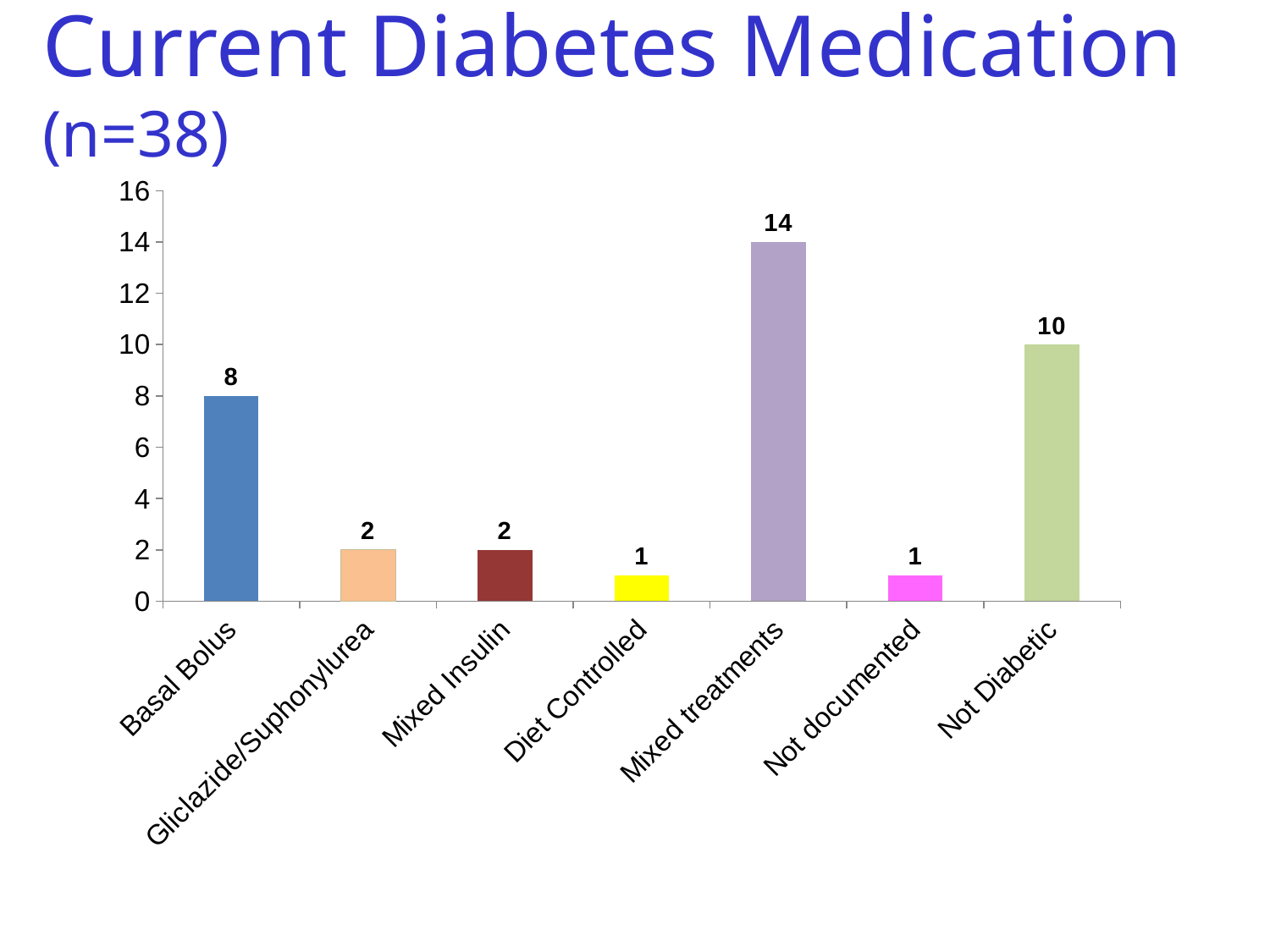
What is the value for Basal Bolus? 8 What is the value for Gliclazide/Suphonylurea? 2 Which is larger, the value for Basal Bolus or the value for Not Diabetic? Not Diabetic How many categories are shown on the x axis? 7 What is the difference between the values for Basal Bolus and Mixed Insulin? 6 What is the difference between the values for Mixed treatments and Not Diabetic? 4 Is the value for Mixed treatments greater or less than 12? greater Which category has the highest value? Mixed treatments What is the value for Not Diabetic? 10 What kind of chart is shown on the slide? bar chart What is the value for Mixed treatments? 14 What is the title of the slide? Current Diabetes Medication (n=38)